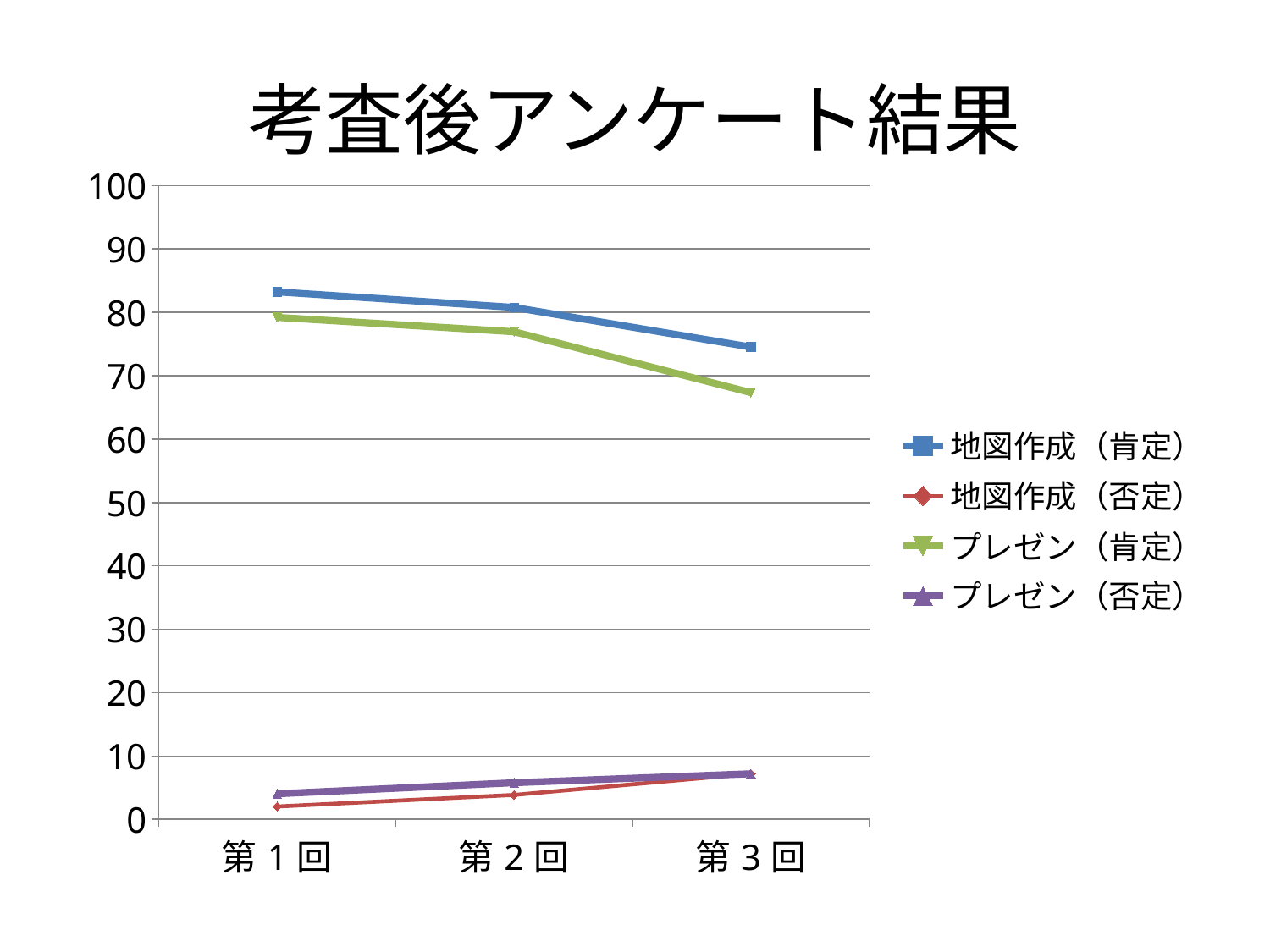
How many series does the legend list? 4 Which series has the highest value at 第１回? 地図作成（肯定） Is the value for 地図作成（肯定） at 第１回 greater or less than 80? greater How many points are plotted along the x axis for each series? 3 What is the title of the chart? 考査後アンケート結果 What kind of chart is shown on the slide? line chart Is the value for プレゼン（否定） at 第３回 greater or less than 10? less At 第３回, which is larger: 地図作成（肯定） or プレゼン（肯定）? 地図作成（肯定） Does the 地図作成（否定） series rise or fall from 第１回 to 第３回? rise Does the 地図作成（肯定） series rise or fall from 第１回 to 第３回? fall Is the value for プレゼン（肯定） at 第３回 greater or less than 70? less Which series has the lowest value at 第１回? 地図作成（否定）